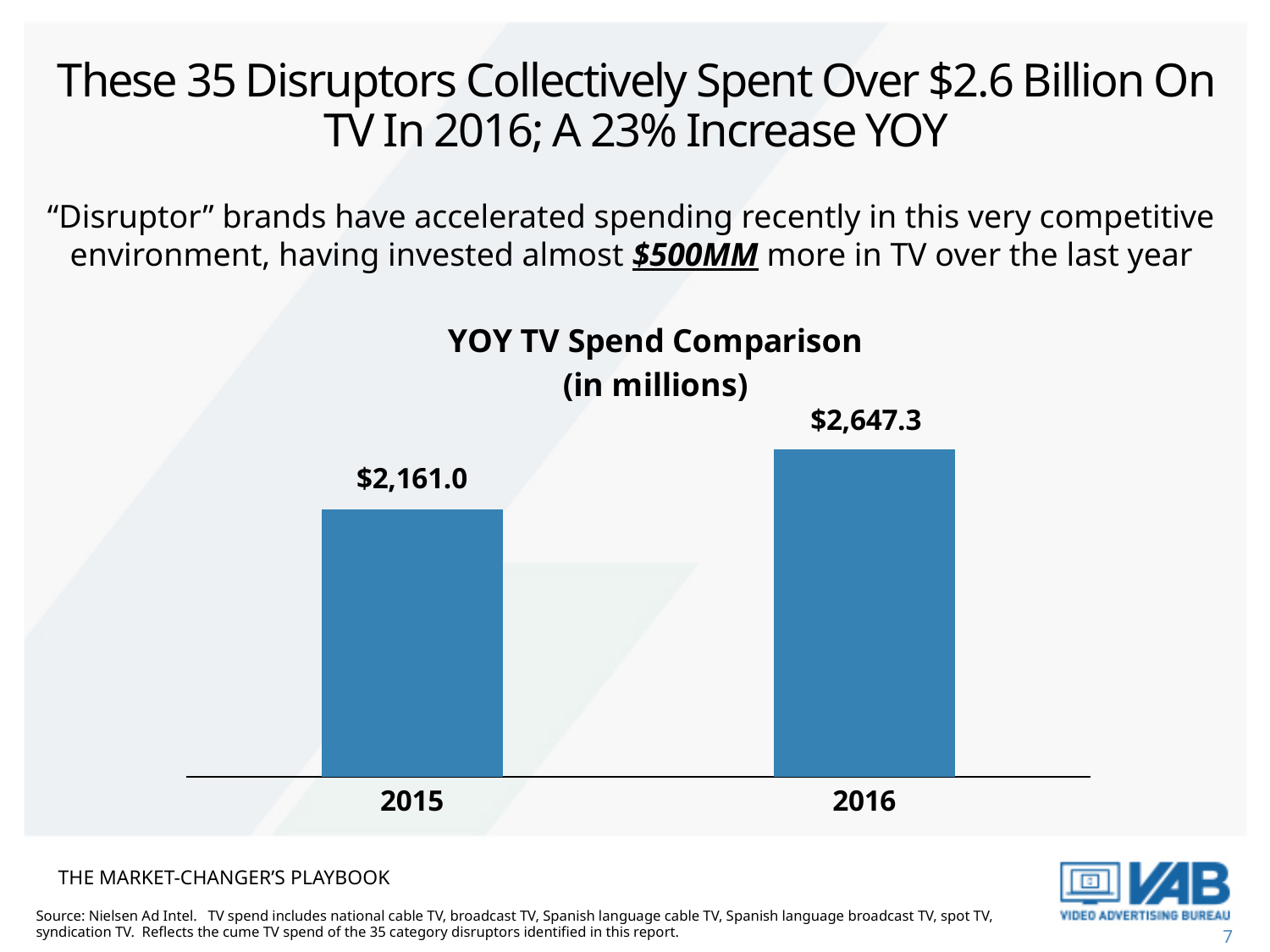
Is the TV spend for 2016 larger or smaller than the TV spend for 2015? larger Which year has the lower TV spend? 2015 What is the title of the chart? YOY TV Spend Comparison (in millions) Which year has the higher TV spend? 2016 What is the TV spend value shown for 2015? $2,161.0 Does TV spend rise or fall from 2015 to 2016? rise What colour are the bars in the chart? blue What is the TV spend value shown for 2016? $2,647.3 What kind of chart is shown on the slide? bar chart What is the difference in TV spend between 2016 and 2015? $486.3 How many years are shown on the chart? 2